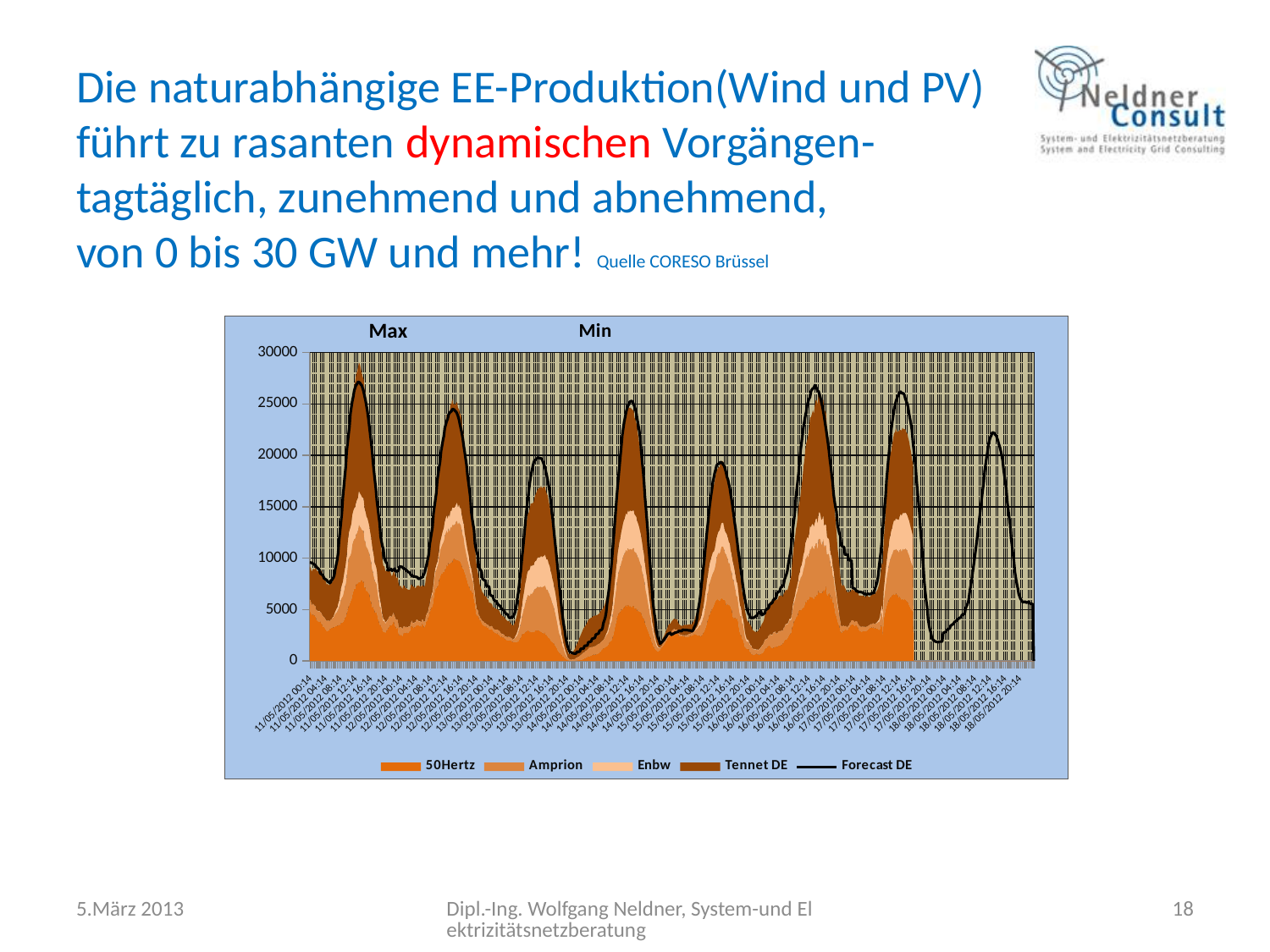
Is the peak of the Forecast DE line on 18/05/2012 greater or less than 25000? less Is the lowest point of the Forecast DE line around 14/05/2012 00:14 greater or less than 5000? less What two labels are printed above the plot area of the chart? Max and Min Is the peak of the Forecast DE line on 11/05/2012 greater or less than 25000? greater How many series does the chart legend list? 5 Which series in the chart is drawn as a black line rather than a filled area? Forecast DE What kind of chart is shown on the slide? stacked area chart with a line series